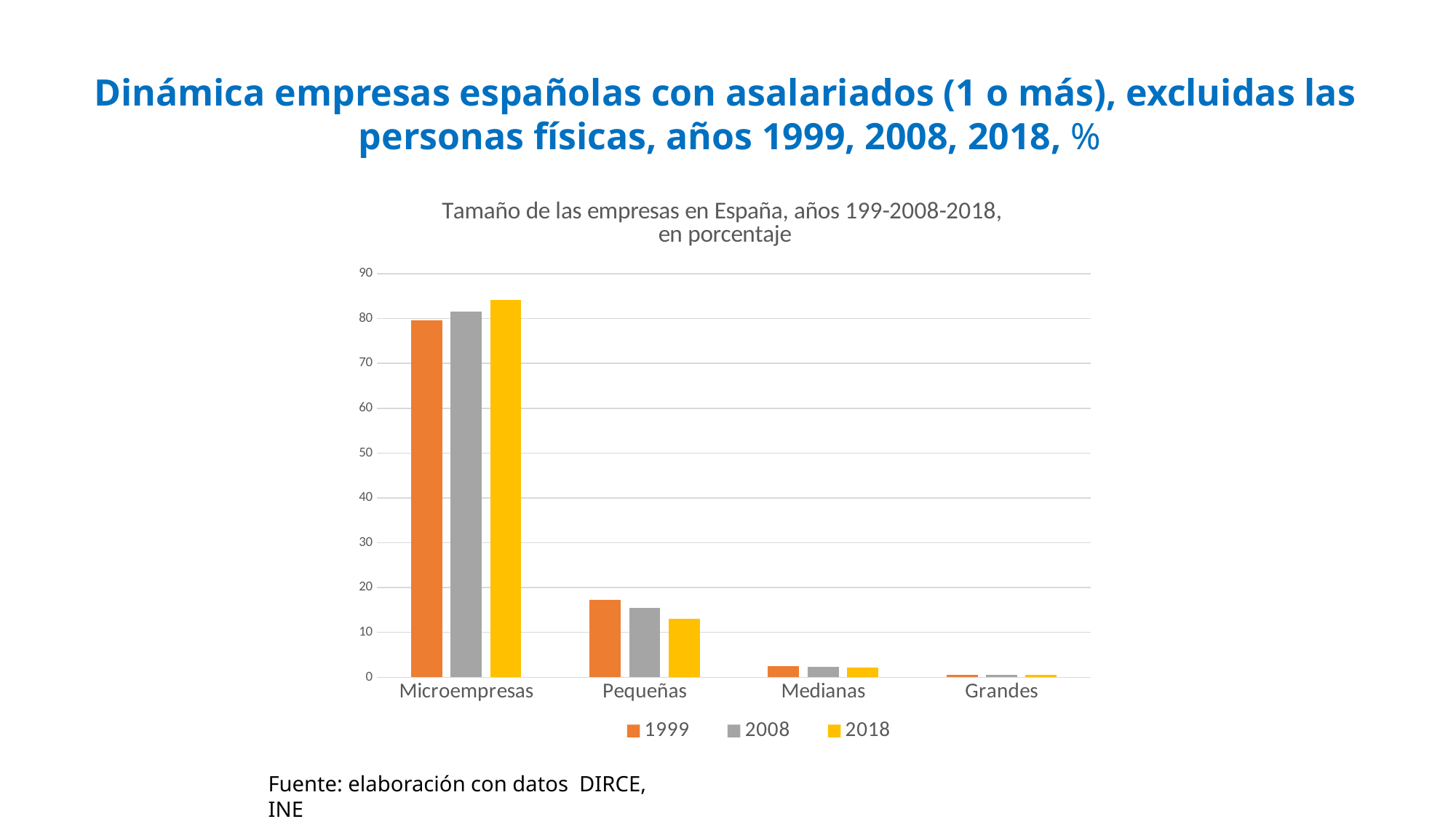
For Microempresas, do the values rise or fall from 1999 to 2018? rise What kind of chart is shown on the slide? bar chart For Pequeñas, which year has the larger value, 1999 or 2018? 1999 How many series does the legend list? 3 Which category has the highest values across all years? Microempresas Which series is shown in yellow in the legend? 2018 Is the value for Microempresas in 2018 greater or less than 80? greater Is the value for Pequeñas in 1999 greater or less than 20? less How many categories are shown on the x axis? 4 Which category has the lowest values across all years? Grandes Is the value for Medianas in 2008 greater or less than 10? less